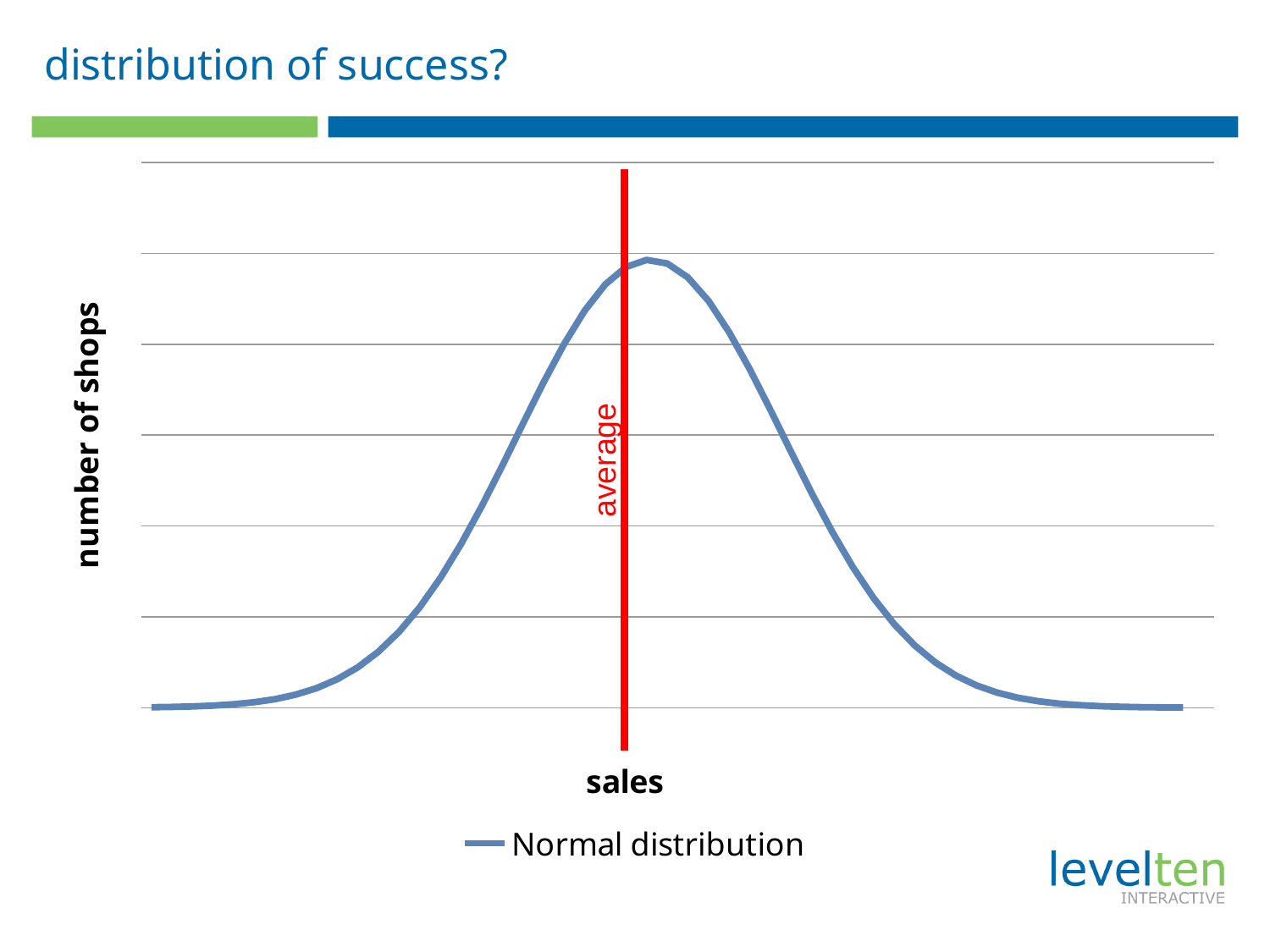
How many series does the legend list? 1 Does the Normal distribution line rise or fall from the left edge of the chart to its peak? rise What kind of chart is shown on the slide? line chart Does the Normal distribution line rise or fall from its peak to the right edge of the chart? fall Overall, does the Normal distribution line rise and then fall, or fall and then rise, along the x axis? rise and then fall What is the label on the vertical axis of the chart? number of shops What is the name of the series listed in the legend? Normal distribution